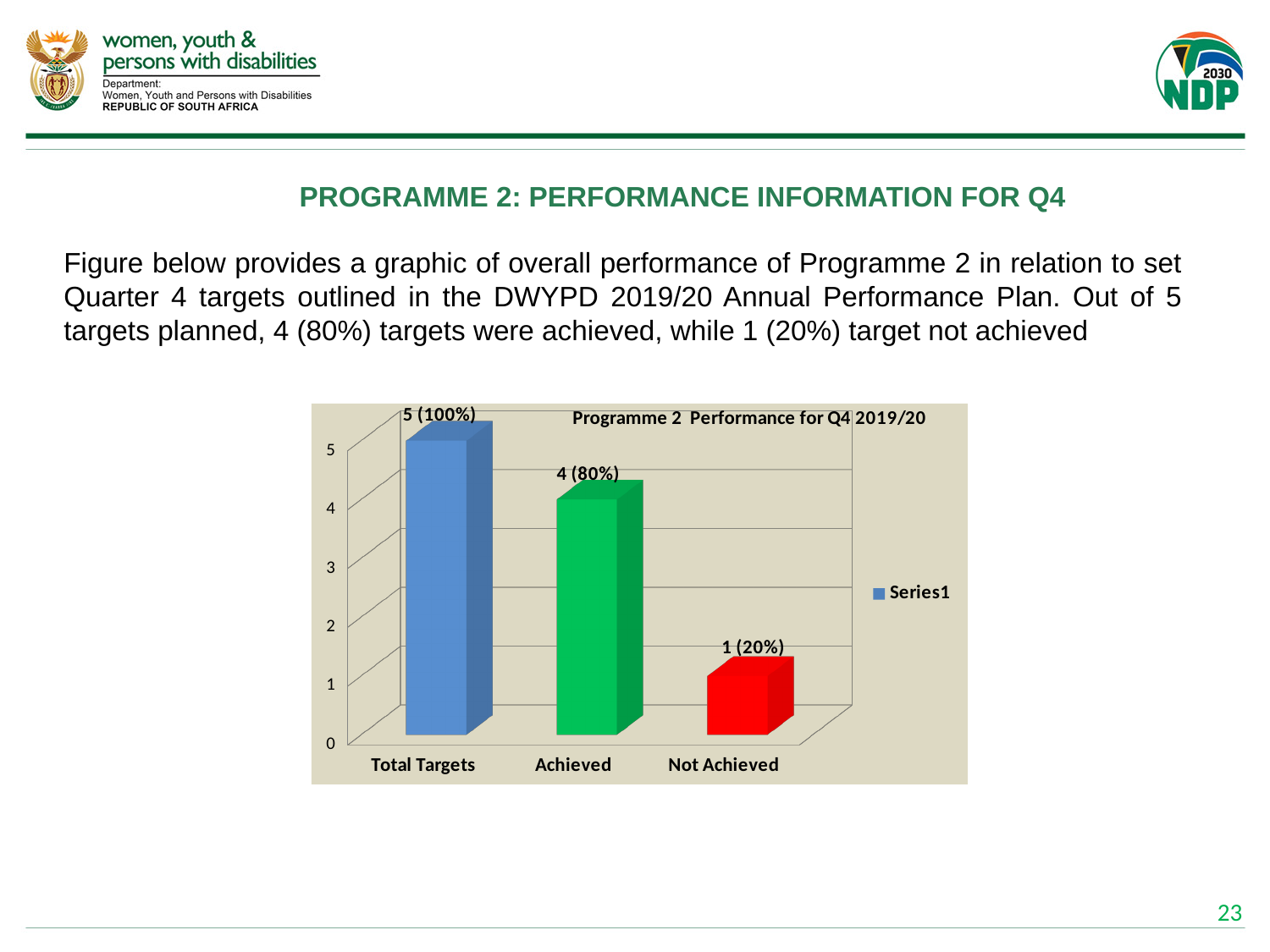
Which is larger, Achieved or Not Achieved? Achieved Which category has the highest value? Total Targets What is the value shown for Achieved? 4 (80%) What is the difference between the Achieved and Not Achieved values? 3 How many series does the legend list? 1 How many categories are shown on the x axis? 3 Which category has the lowest value? Not Achieved What colour is the bar for Not Achieved? Red What is the title of the chart? Programme 2 Performance for Q4 2019/20 What is the value shown for Not Achieved? 1 (20%) What kind of chart is shown? Bar chart What is the value shown for Total Targets? 5 (100%)